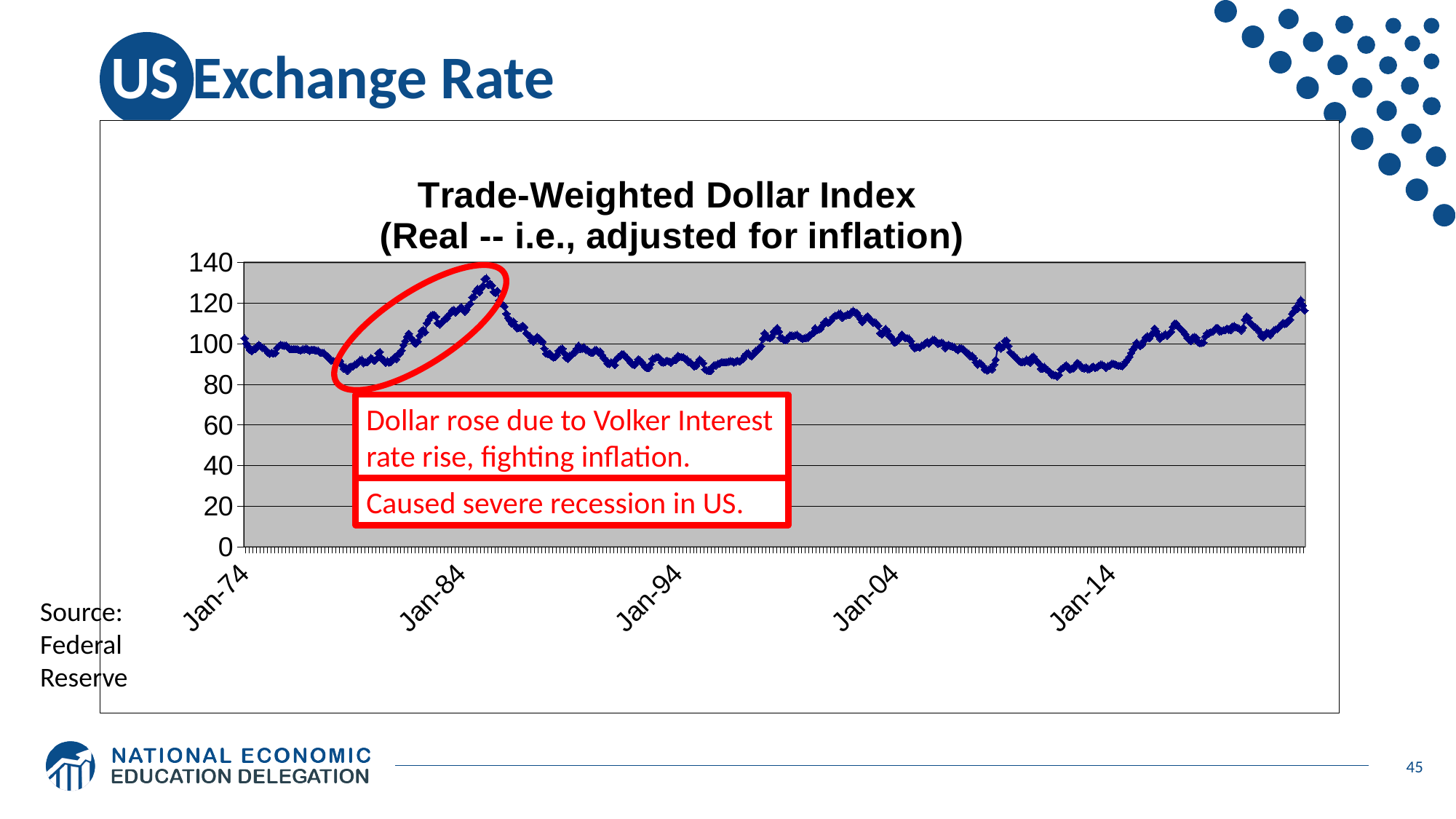
What kind of chart is shown on the slide? line chart Is the value of the Trade-Weighted Dollar Index at Jan-84 greater or less than 100? greater Is the highest peak of the Trade-Weighted Dollar Index greater or less than 120? greater Is the value of the Trade-Weighted Dollar Index at Jan-14 greater or less than 100? less What is the title of the chart? Trade-Weighted Dollar Index (Real -- i.e., adjusted for inflation) What is the highest value shown on the y axis of the chart? 140 How many date labels are shown on the x axis of the chart? 5 Does the Trade-Weighted Dollar Index rise or fall between its mid-1980s peak and Jan-94? fall Does the Trade-Weighted Dollar Index rise or fall between Jan-74 and Jan-84? rise Which value is larger on the chart: the index at Jan-04 or the index at Jan-14? Jan-04